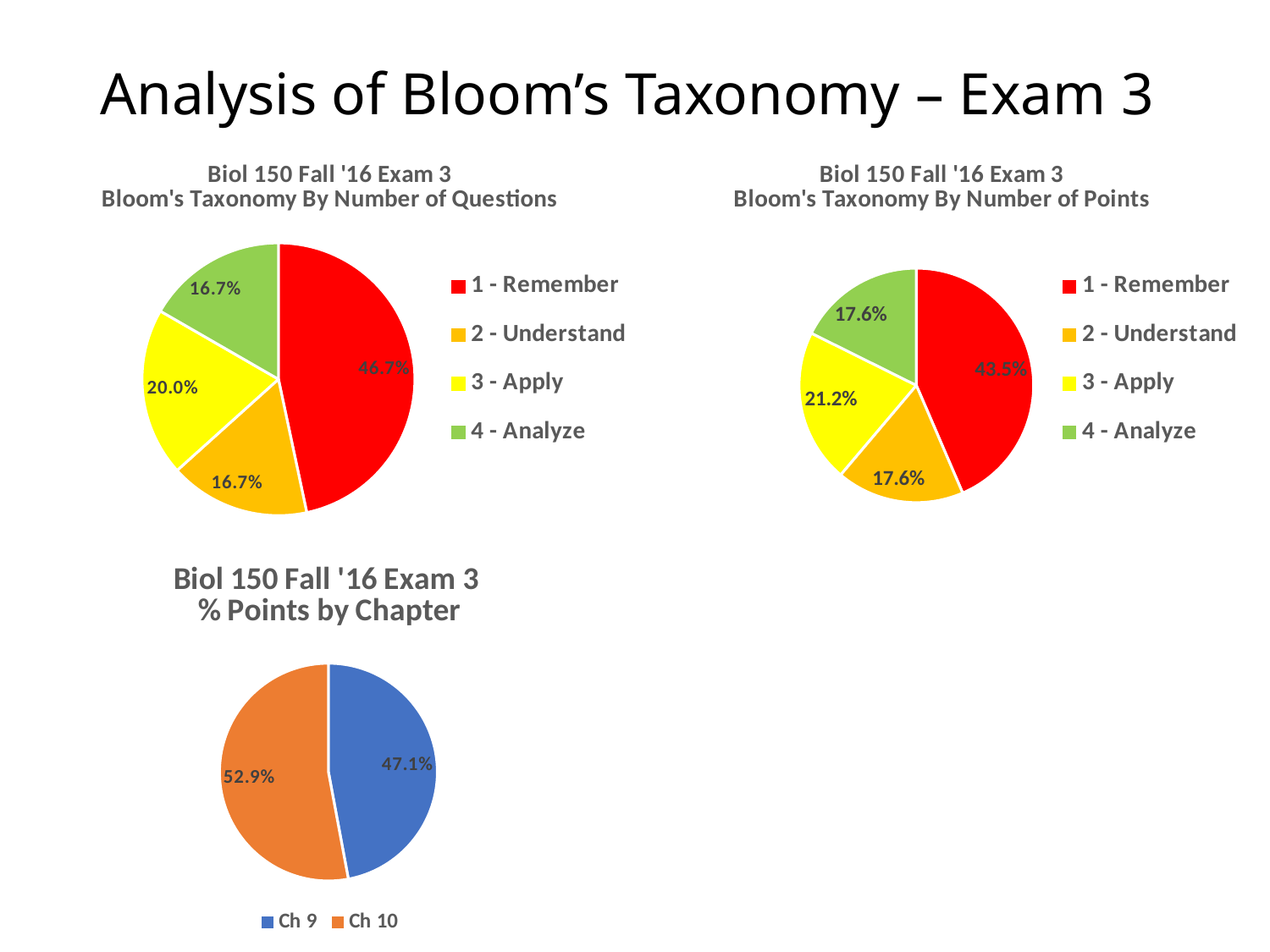
In the 'Bloom's Taxonomy By Number of Questions' pie chart, which category has the largest slice? 1 - Remember In the '% Points by Chapter' pie chart, what share is labelled for Ch 10? 52.9% In the 'Bloom's Taxonomy By Number of Questions' pie chart, what share is labelled for 1 - Remember? 46.7% In the 'Bloom's Taxonomy By Number of Questions' pie chart, what is the difference between the shares for 1 - Remember and 3 - Apply? 26.7% In the 'Bloom's Taxonomy By Number of Points' pie chart, what share is labelled for 3 - Apply? 21.2% How many categories does the legend of the 'Bloom's Taxonomy By Number of Points' pie chart list? 4 What kind of chart is the '% Points by Chapter' chart? Pie chart In the 'Bloom's Taxonomy By Number of Points' pie chart, which is larger, the share for 3 - Apply or the share for 2 - Understand? 3 - Apply In the 'Bloom's Taxonomy By Number of Questions' pie chart, what colour is the 3 - Apply slice? Yellow In the '% Points by Chapter' pie chart, which chapter has the larger slice? Ch 10